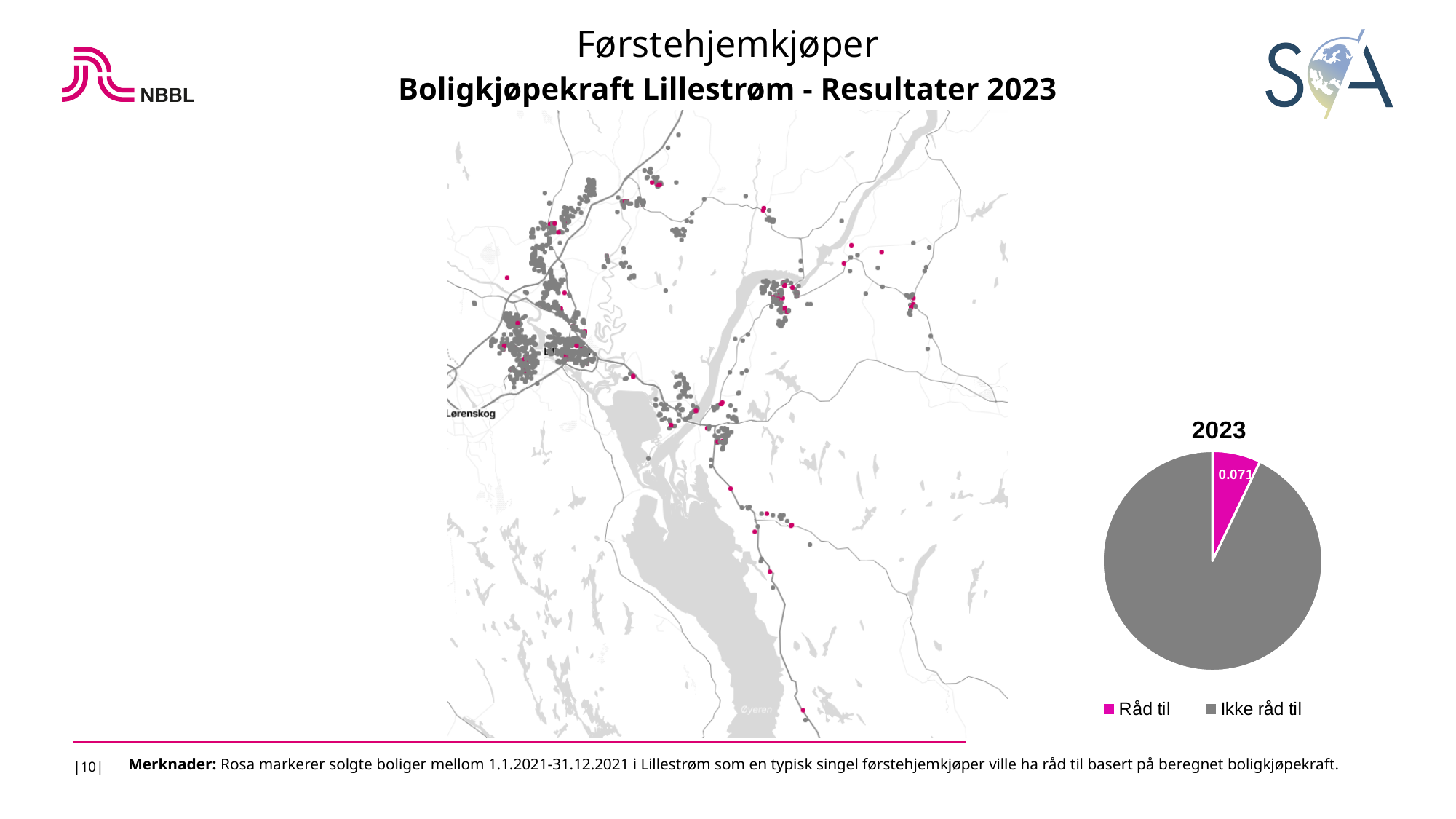
In the 2023 pie chart, what share of the pie does the Råd til slice represent? 0.071 In the 2023 pie chart, which category has the smallest slice? Råd til How many slices does the 2023 pie chart have? 2 In the 2023 pie chart, what colour is the Råd til slice? pink What kind of chart is the chart titled 2023 on the right of the slide? pie chart In the 2023 pie chart, which category has the largest slice? Ikke råd til How many entries does the legend of the 2023 pie chart list? 2 In the 2023 pie chart, what value is shown for Råd til? 0.071 What is the title of the pie chart on the right of the slide? 2023 In the 2023 pie chart, which is larger: Råd til or Ikke råd til? Ikke råd til